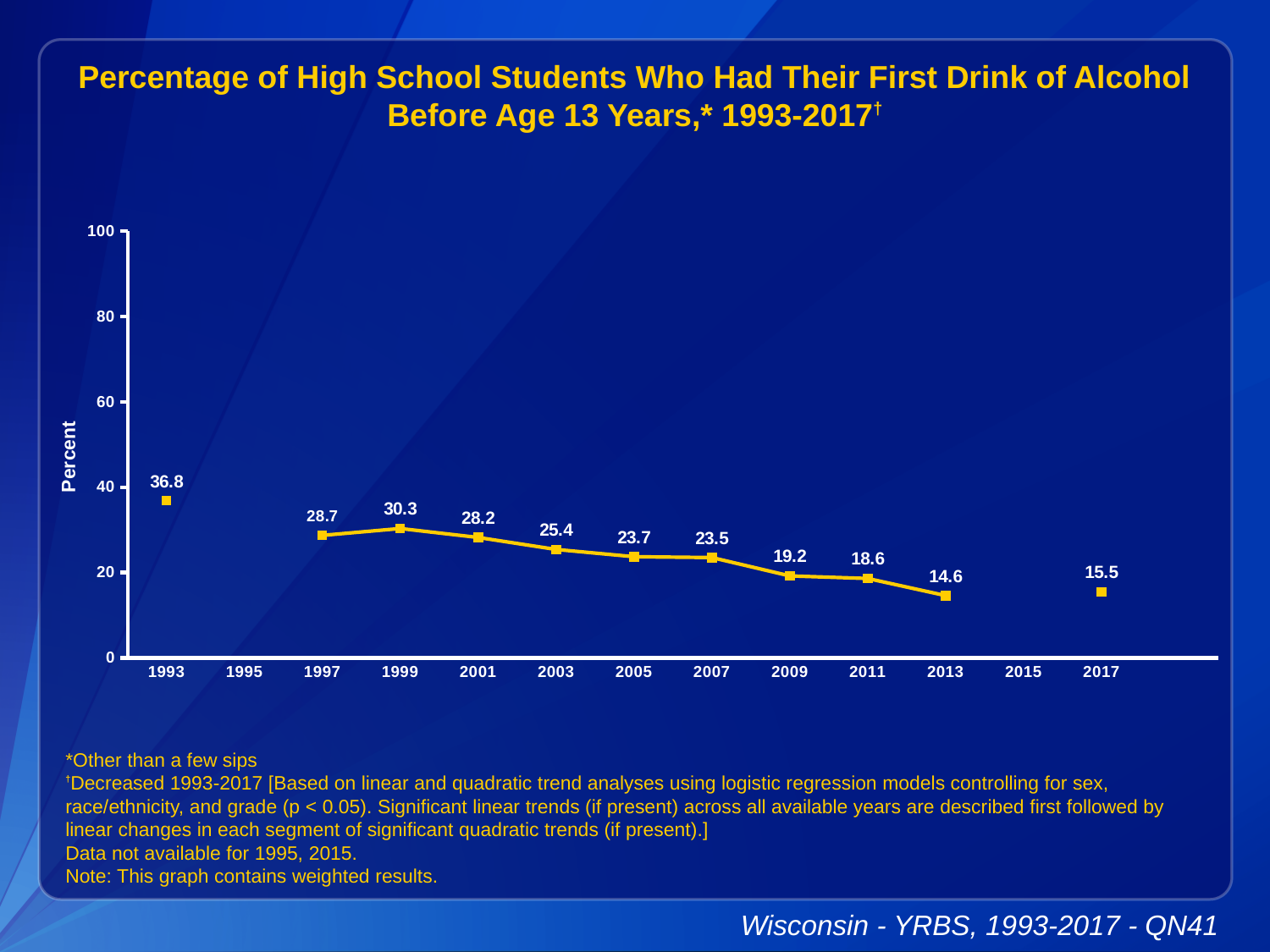
What is the value for 2017? 15.5 Which year has the lowest value? 2013 Which year has the highest value? 1993 Do the values generally rise or fall from 1993 to 2017? fall What kind of chart is shown? line chart What is the value for 1993? 36.8 Is the value for 2005 greater or less than 20? greater What is the value for 2009? 19.2 What is the label on the y axis? Percent How many data points are plotted on the chart? 11 What is the difference between the values for 1993 and 2017? 21.3 Which is larger, the value for 1997 or the value for 1999? 1999